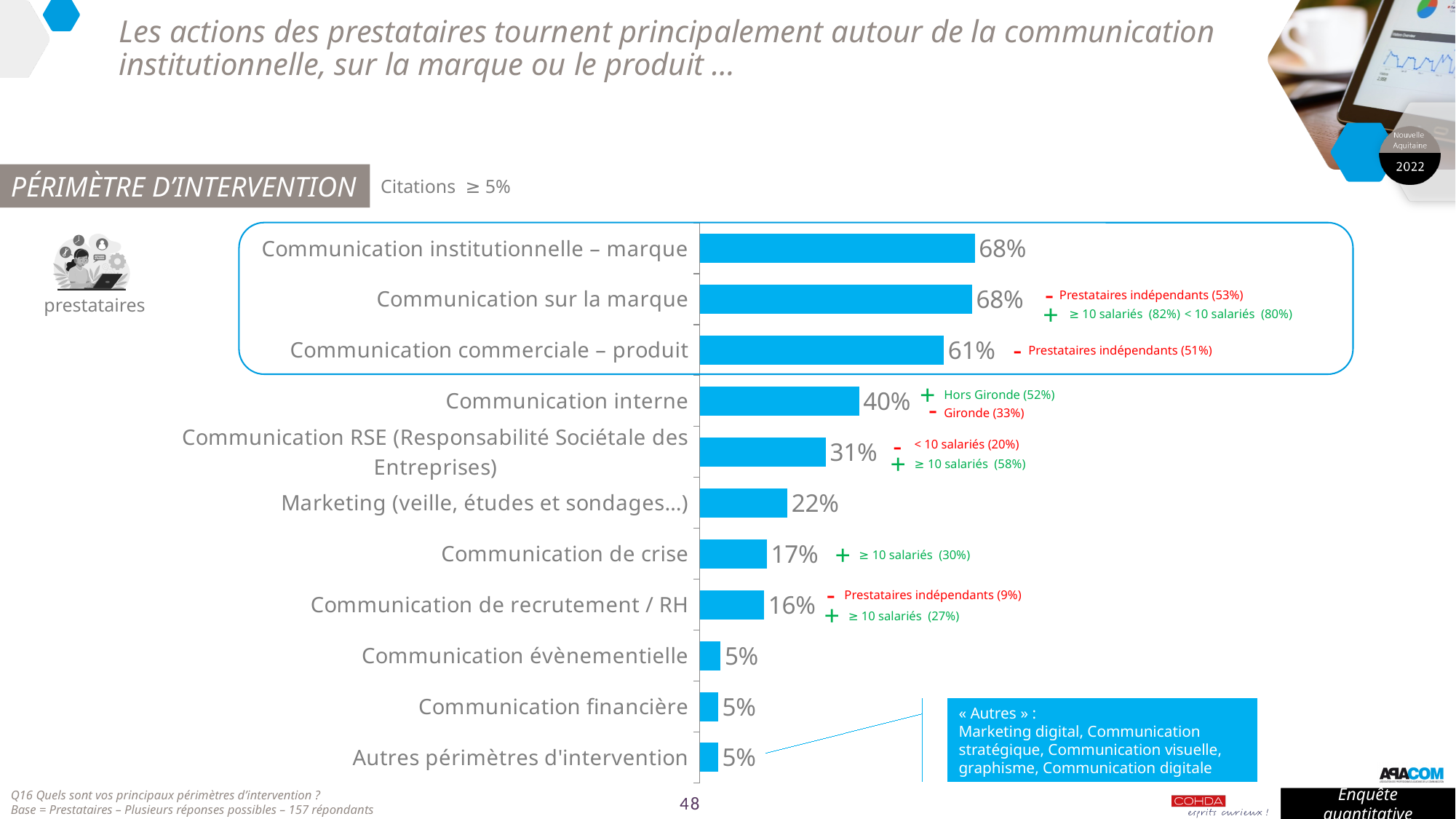
Which is larger, the value for Communication de crise or the value for Communication évènementielle? Communication de crise How many categories are shown in the bar chart? 11 What is the value for Communication interne? 40% What is the value for Marketing (veille, études et sondages…)? 22% Which is larger, the value for Communication interne or the value for Marketing (veille, études et sondages…)? Communication interne What is the difference between the values for Communication sur la marque and Communication commerciale – produit? 7 percentage points What is the value for Communication financière? 5% What is the value for Communication commerciale – produit? 61% What kind of chart is shown on the slide? Bar chart What is the value for Communication RSE (Responsabilité Sociétale des Entreprises)? 31% What is the value for Communication de recrutement / RH? 16% Do the values rise or fall going from the top bar to the bottom bar? Fall